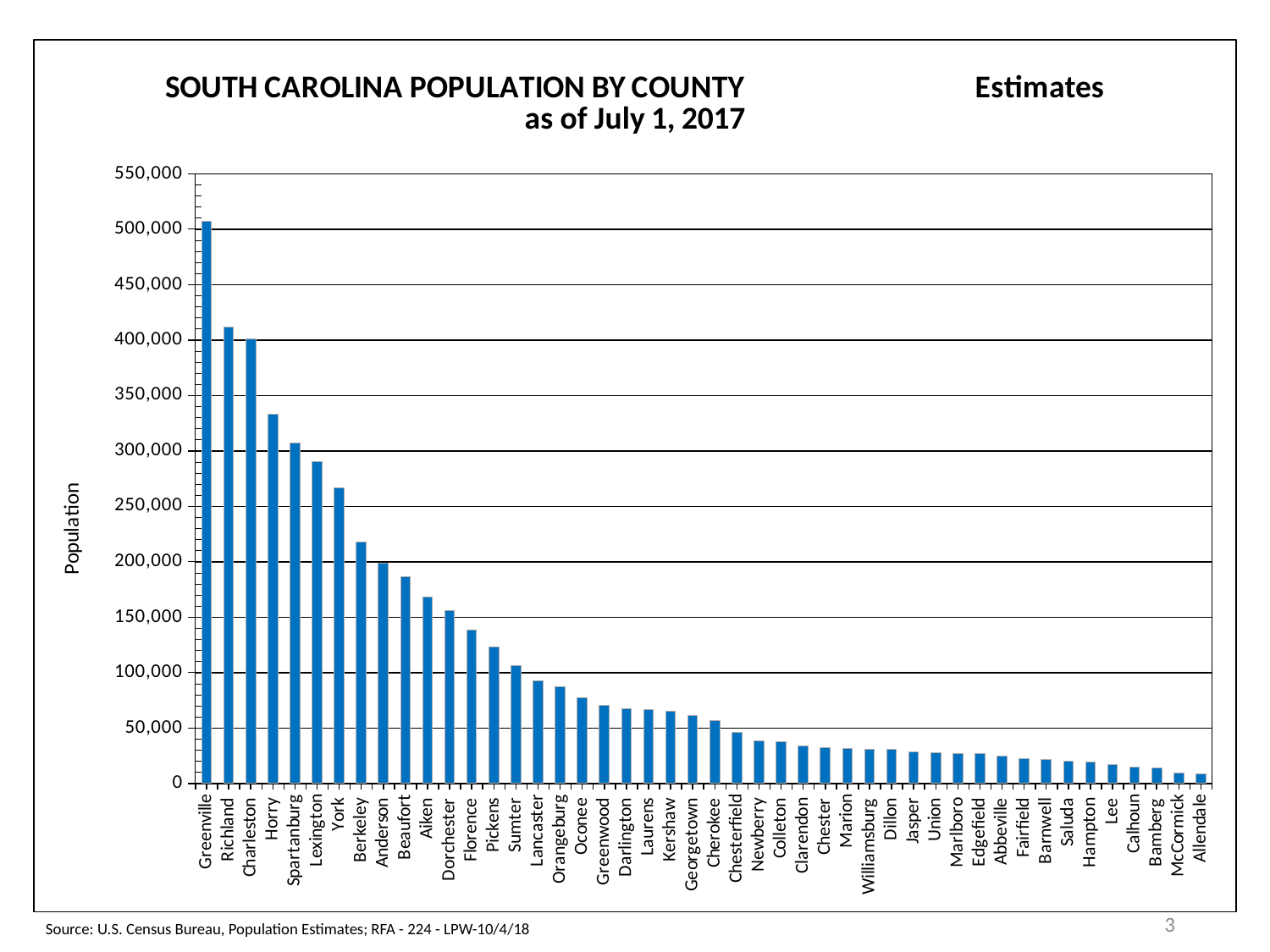
What kind of chart is shown on the slide? bar chart Is the population value for Horry greater or less than 300,000? greater Is the population value for Allendale greater or less than 50,000? less Is the population value for Lancaster greater or less than 100,000? less What is the label on the vertical axis of the chart? Population Do the population values rise or fall moving from left to right along the x axis? fall Which county has the highest population in the chart? Greenville How many counties are shown on the x axis of the chart? 46 Which county has the larger population, Horry or Spartanburg? Horry